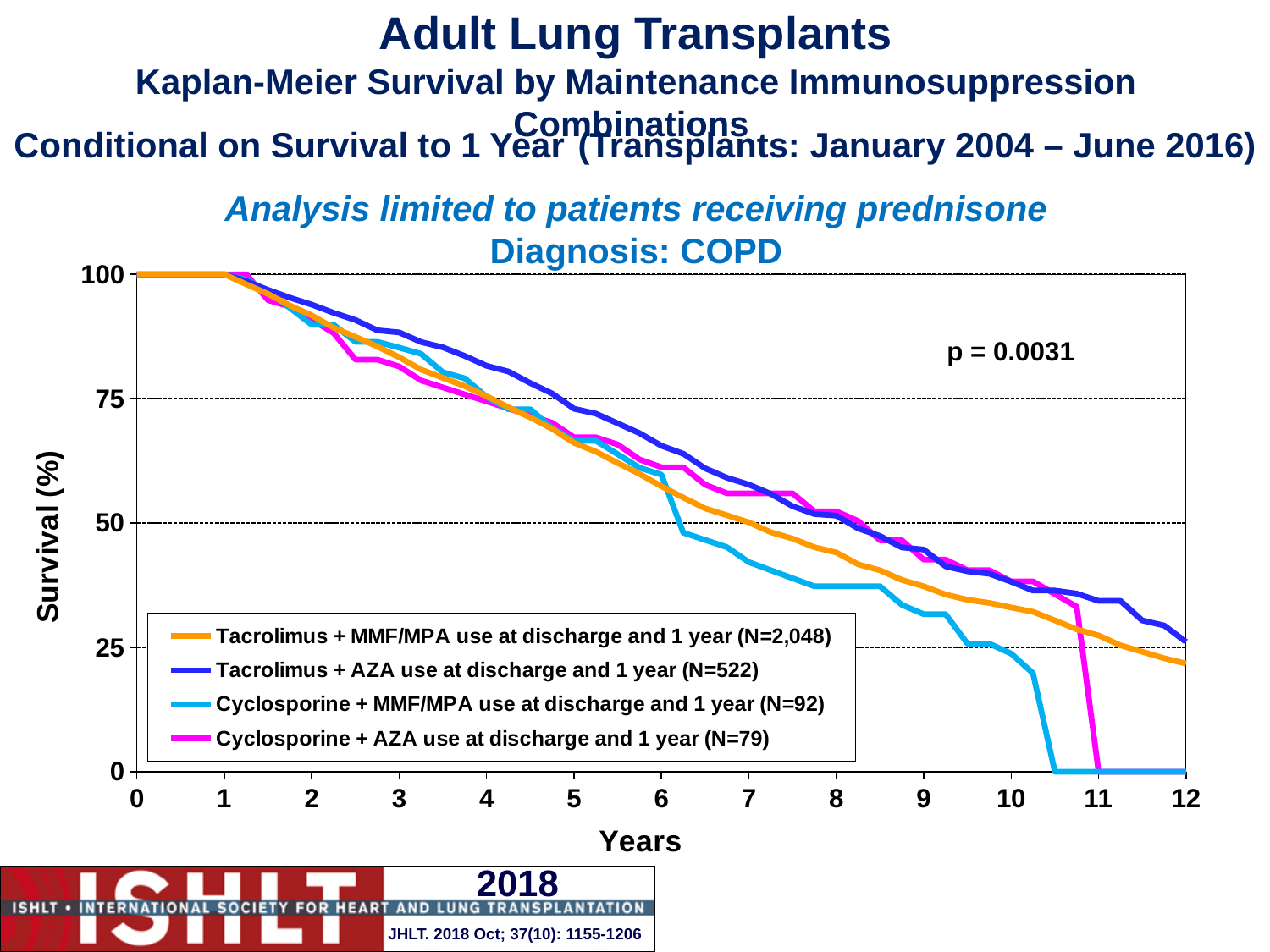
At 9 years, which has higher survival: Tacrolimus + AZA or Cyclosporine + MMF/MPA? Tacrolimus + AZA Do the survival curves rise or fall as years increase? Fall What kind of chart is shown on the slide? Line chart What is the label of the y-axis? Survival (%) How many series does the legend list? 4 Which group's survival curve drops to 0% first? Cyclosporine + MMF/MPA use at discharge and 1 year What is the N for the Tacrolimus + MMF/MPA use at discharge and 1 year group? N=2,048 What p-value is printed on the chart? p = 0.0031 What is the N for the Tacrolimus + AZA use at discharge and 1 year group? N=522 What is the N for the Cyclosporine + AZA use at discharge and 1 year group? N=79 Is the survival for Tacrolimus + AZA at 4 years greater or less than 75? greater Is the survival for Cyclosporine + MMF/MPA at 8 years greater or less than 50? less